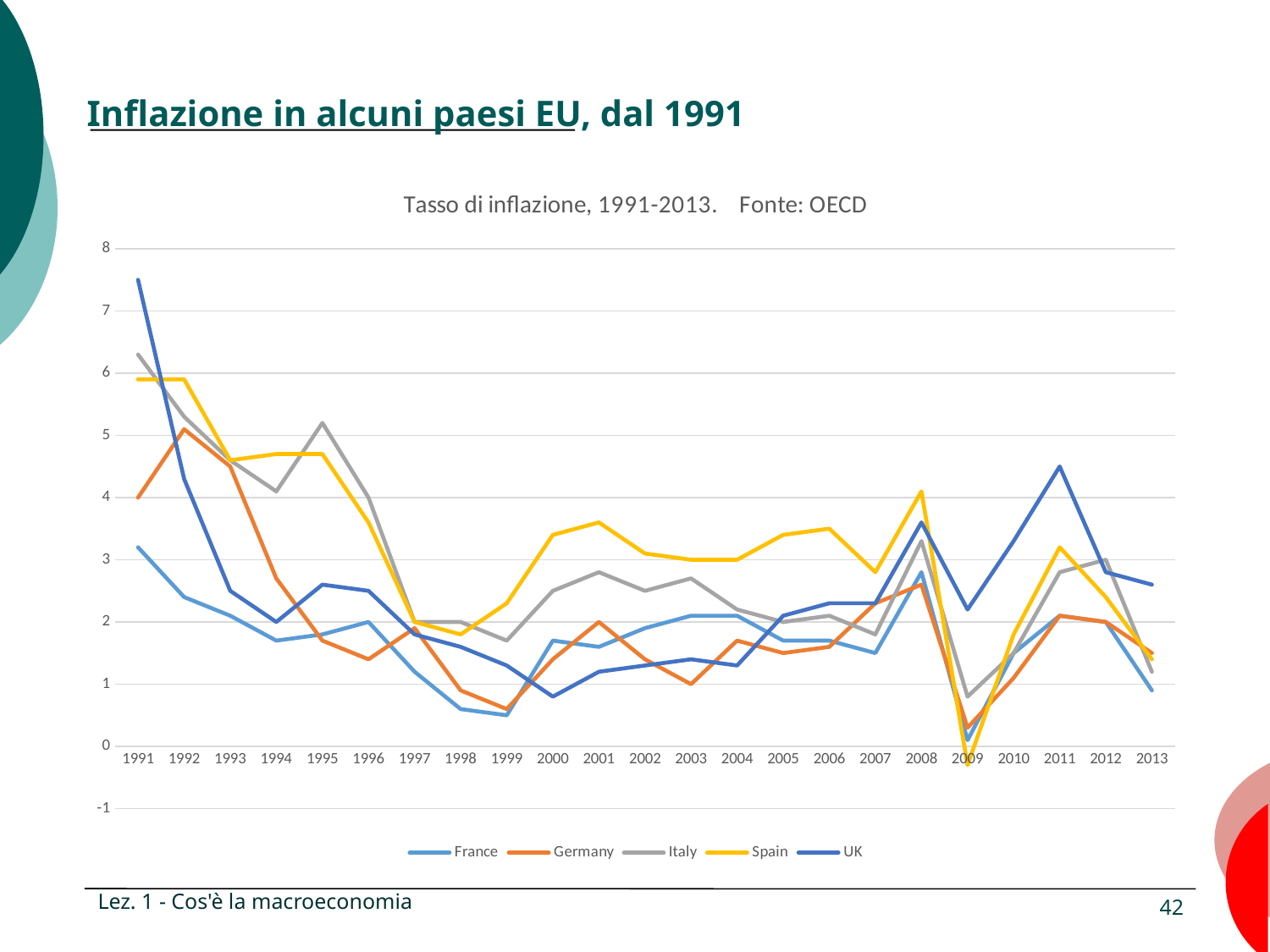
Is the value for France in 1999 greater or less than 1? less In 2001, which has the higher inflation rate, Spain or France? Spain What is the source of the data given in the chart title? OECD Does the UK inflation rate rise or fall from 1991 to 1994? fall How many series does the legend list? 5 Which country has the highest inflation rate in 2011? UK Which country has the lowest inflation rate in 2009? Spain Is the value for Italy in 1991 greater or less than 5? greater Is the value for UK in 1991 greater or less than 7? greater Which country has the highest inflation rate in 1991? UK How many years are shown on the x axis? 23 What kind of chart is shown on the slide? line chart